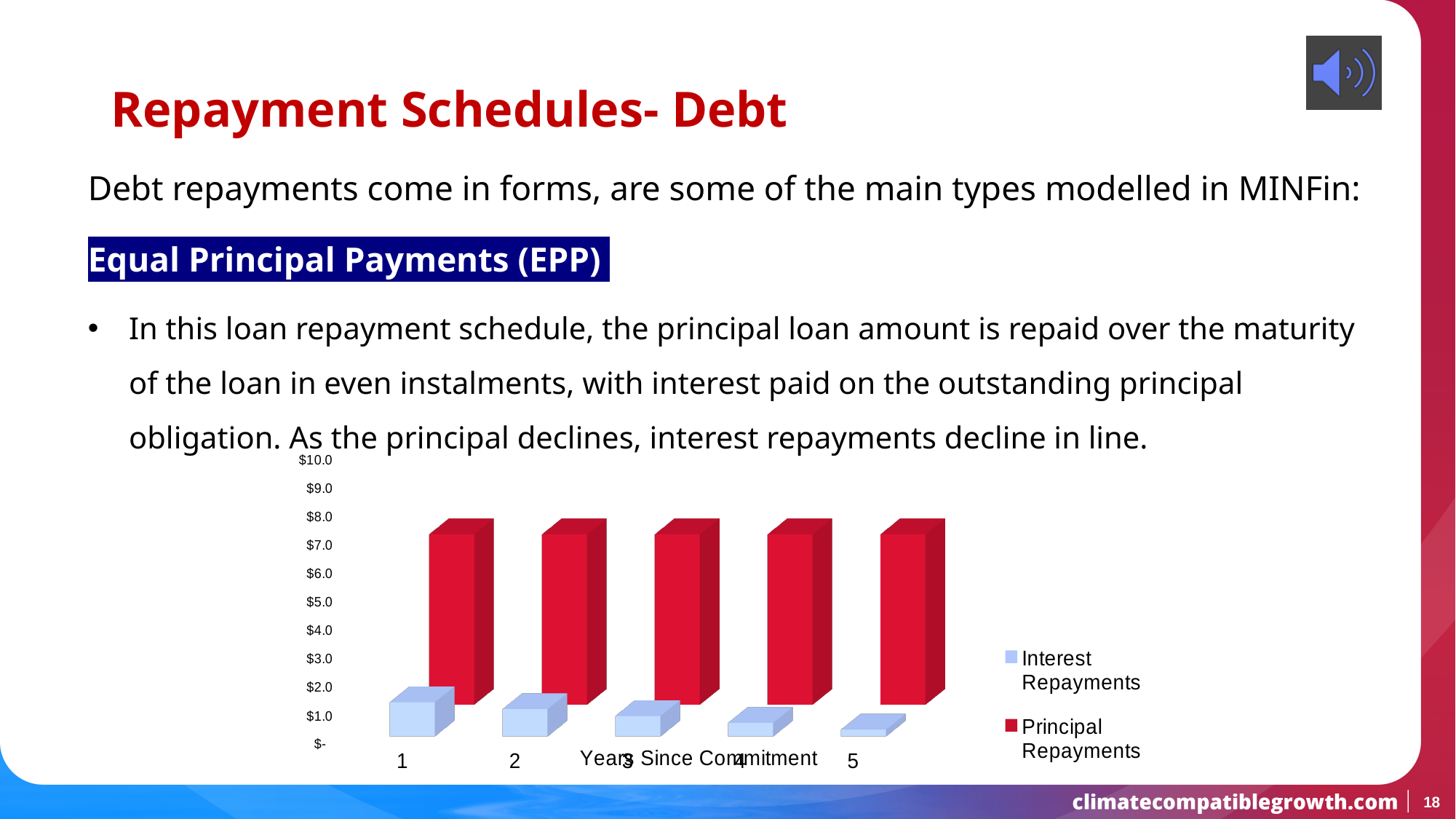
How many series does the chart legend list? 2 Is the Interest Repayments value for year 5 greater or less than $1.0? less Is the Interest Repayments value for year 1 greater or less than $3.0? less Is the Principal Repayments value for year 1 greater or less than $5.0? greater How many years (categories) are shown along the x axis of the chart? 5 What is the title of the x axis of the chart? Years Since Commitment In which year are Interest Repayments highest? 1 In which year are Interest Repayments lowest? 5 What colour are the Principal Repayments bars in the chart? red What kind of chart is shown on the slide? bar chart In year 1, which is larger: Principal Repayments or Interest Repayments? Principal Repayments Do the Interest Repayments values rise or fall as the years since commitment increase? fall